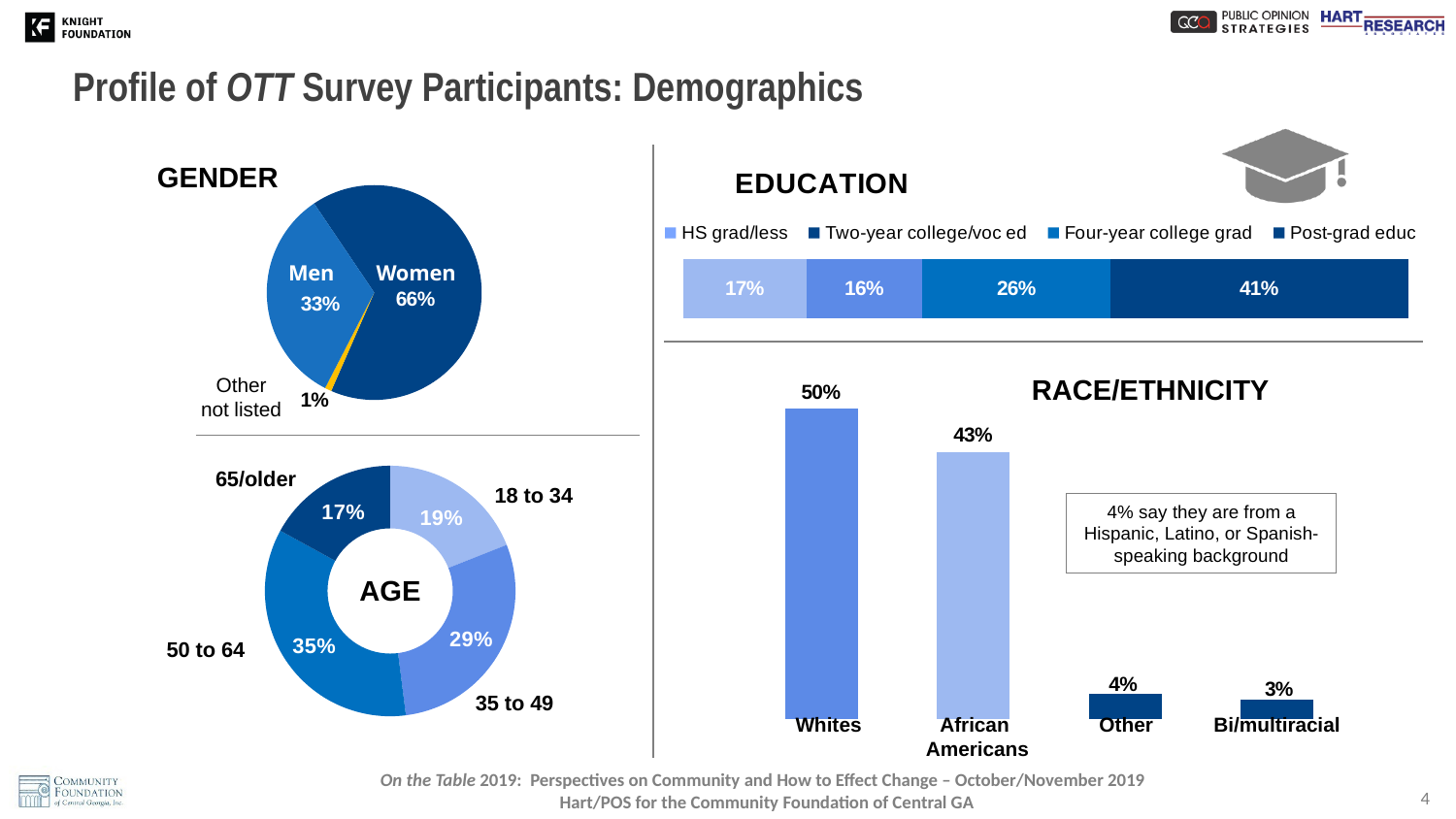
In the EDUCATION stacked bar, which category has the smallest share? Two-year college/voc ed In the GENDER pie chart, what is the difference between the Women and Men shares? 33 percentage points In the AGE donut chart, which age group has the smallest share? 65/older What type of chart is the RACE/ETHNICITY chart? Bar chart In the AGE donut chart, what percentage of participants are 50 to 64? 35% In the GENDER pie chart, what percentage of participants are women? 66% In the EDUCATION stacked bar, what percentage of participants have post-grad education? 41% In the RACE/ETHNICITY chart, what is the difference between Whites and African Americans? 7 percentage points In the GENDER pie chart, what percentage of participants are men? 33% How many categories does the EDUCATION legend list? 4 In the RACE/ETHNICITY chart, what percentage of participants are African Americans? 43% In the AGE donut chart, how many age groups are shown? 4